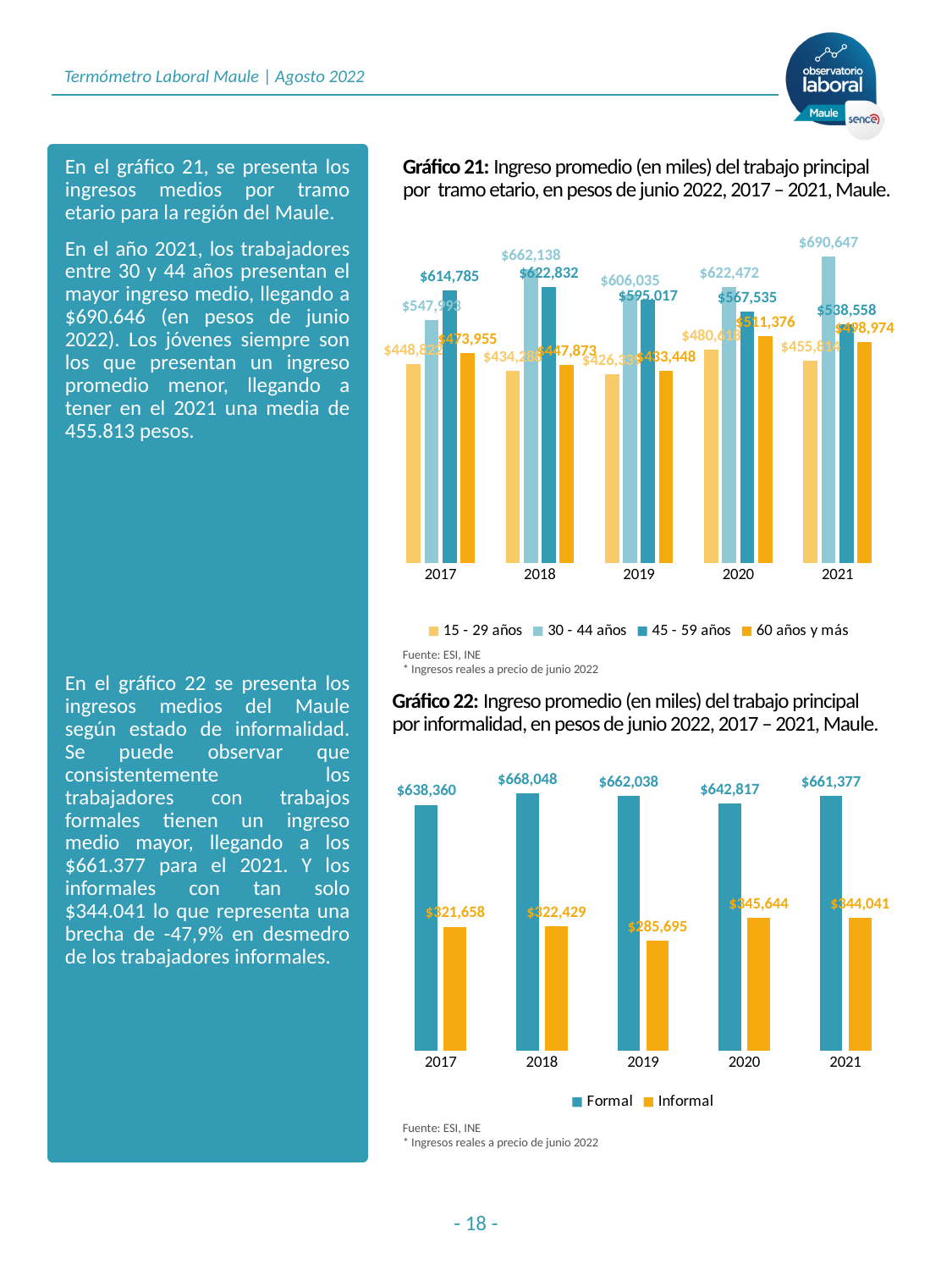
In Gráfico 21, how many age groups does the legend list? 4 What kind of chart is Gráfico 22? Bar chart In Gráfico 21, which is larger in 2020: 30 - 44 años or 45 - 59 años? 30 - 44 años In Gráfico 21, which year has the highest value for 30 - 44 años? 2021 In Gráfico 22, which year has the lowest Informal value? 2019 In Gráfico 21, what is the value for 60 años y más in 2019? $433,448 In Gráfico 22, what is the Formal value for 2021? $661,377 In Gráfico 22, what is the difference between the Formal and Informal values in 2021? $317,336 In Gráfico 22, how many series does the legend list? 2 In Gráfico 22, what is the Informal value for 2019? $285,695 In Gráfico 21, what is the value for 30 - 44 años in 2021? $690,647 In Gráfico 22, which year has the highest Formal value? 2018